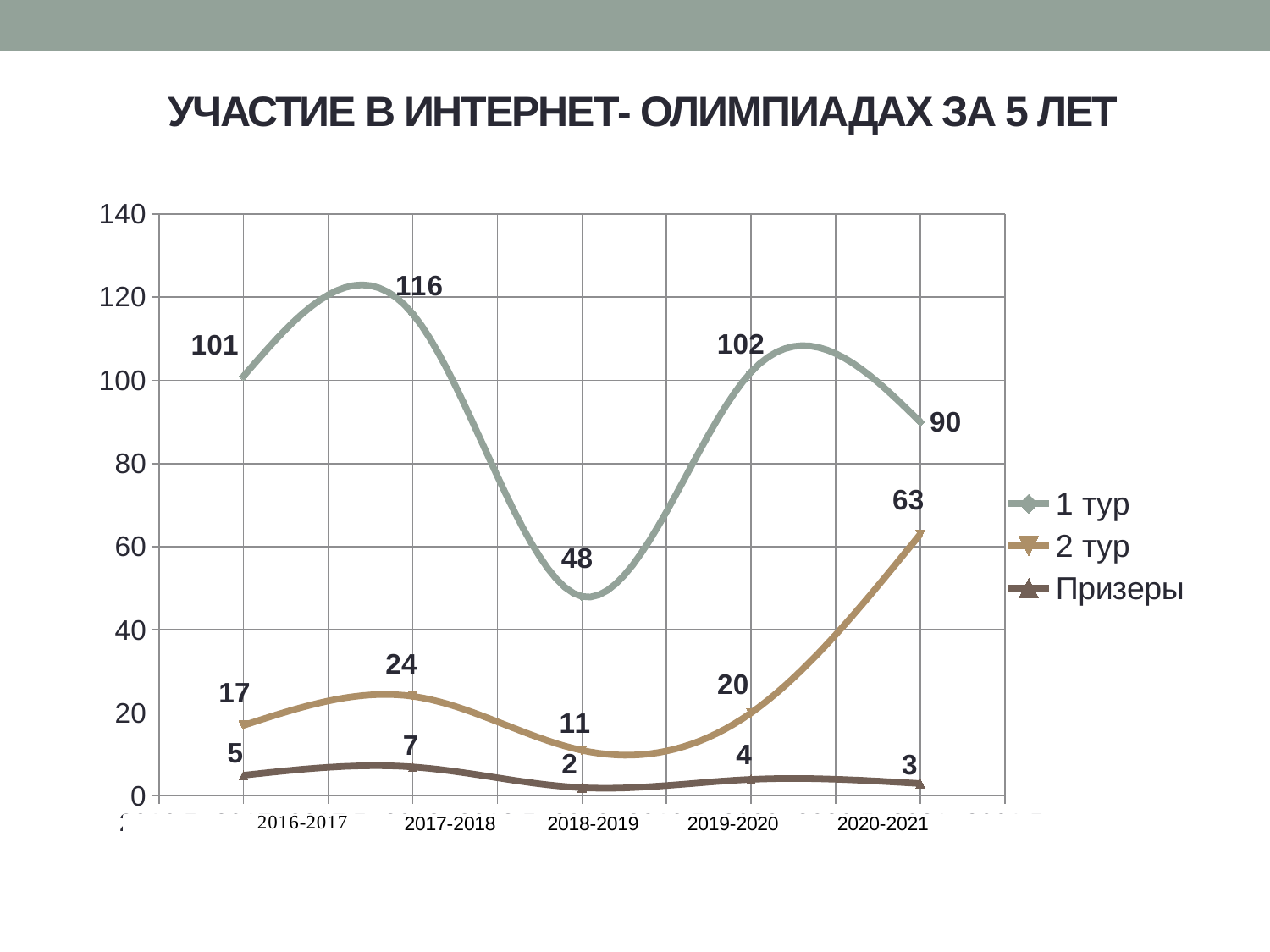
What is the title of the chart? УЧАСТИЕ В ИНТЕРНЕТ- ОЛИМПИАДАХ ЗА 5 ЛЕТ In which year is the value for "1 тур" lowest? 2018-2019 Which is larger: the "1 тур" value in 2016-2017 or in 2019-2020? 2019-2020 How many academic years are plotted along the x axis? 5 What is the value for "1 тур" in 2017-2018? 116 How many series does the legend list? 3 What type of chart is shown on the slide? Line chart What is the value for "Призеры" in 2018-2019? 2 Does the "2 тур" series rise or fall from 2019-2020 to 2020-2021? Rise In which year is the value for "2 тур" highest? 2020-2021 What is the value for "2 тур" in 2020-2021? 63 What is the difference between the "1 тур" values in 2017-2018 and 2018-2019? 68